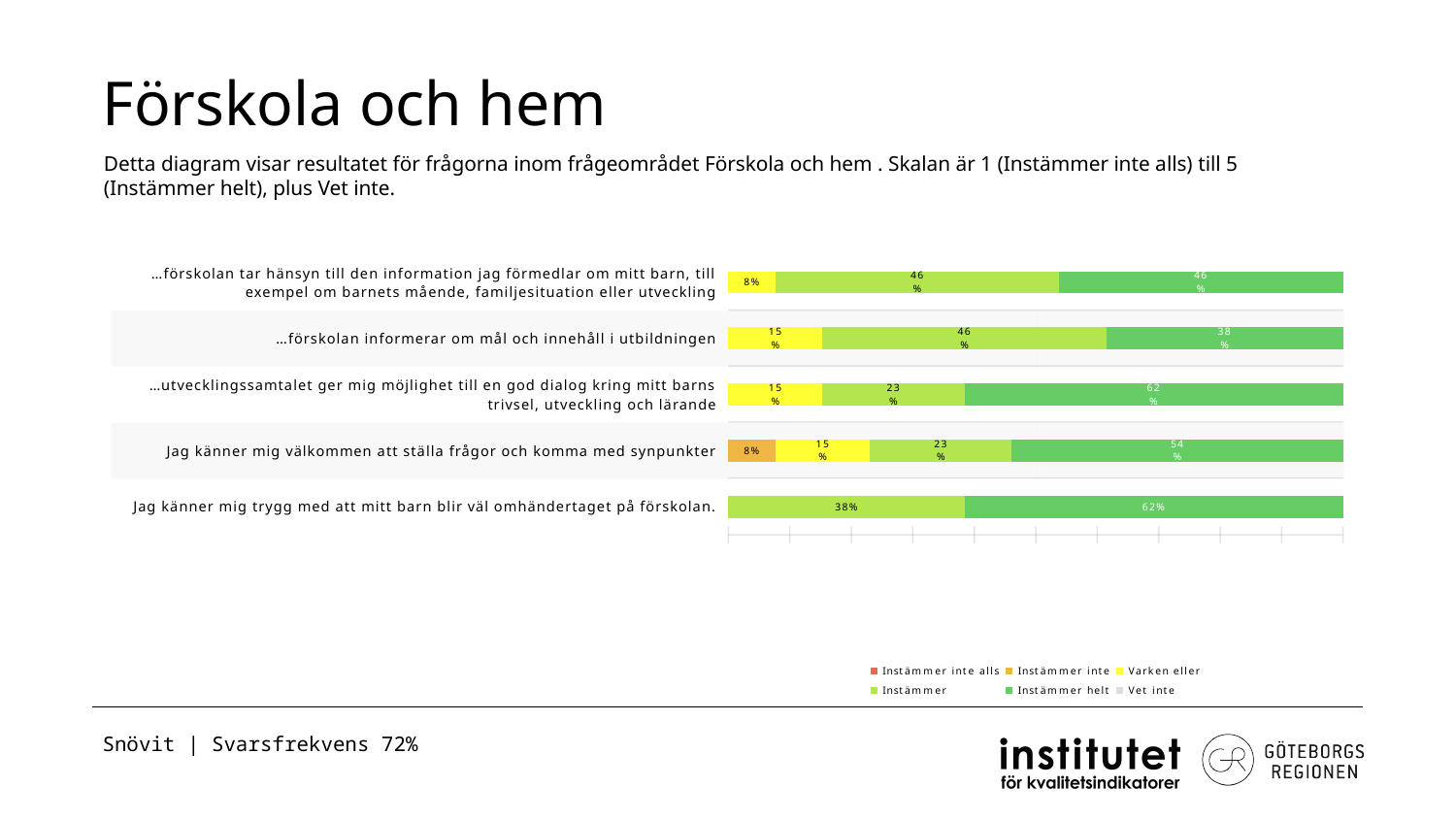
What is the 'Instämmer inte' value for 'Jag känner mig välkommen att ställa frågor och komma med synpunkter'? 8% What is the title of the slide containing the chart? Förskola och hem What is the combined share of 'Instämmer' and 'Instämmer helt' for '…förskolan tar hänsyn till den information jag förmedlar om mitt barn, till exempel om barnets mående, familjesituation eller utveckling'? 92% Which statement has the lowest 'Instämmer helt' value? …förskolan informerar om mål och innehåll i utbildningen What is the difference between the 'Instämmer helt' and 'Instämmer' values for '…utvecklingssamtalet ger mig möjlighet till en god dialog kring mitt barns trivsel, utveckling och lärande'? 39% What is the 'Instämmer' value for '…förskolan informerar om mål och innehåll i utbildningen'? 46% What kind of chart is shown on the slide? Stacked bar chart How many statements (categories) are plotted in the chart? 5 What is the 'Instämmer helt' value for 'Jag känner mig trygg med att mitt barn blir väl omhändertaget på förskolan.'? 62% What is the 'Varken eller' value for '…utvecklingssamtalet ger mig möjlighet till en god dialog kring mitt barns trivsel, utveckling och lärande'? 15% Which is larger for 'Jag känner mig välkommen att ställa frågor och komma med synpunkter': the 'Instämmer' value or the 'Instämmer helt' value? Instämmer helt How many series does the legend list? 6